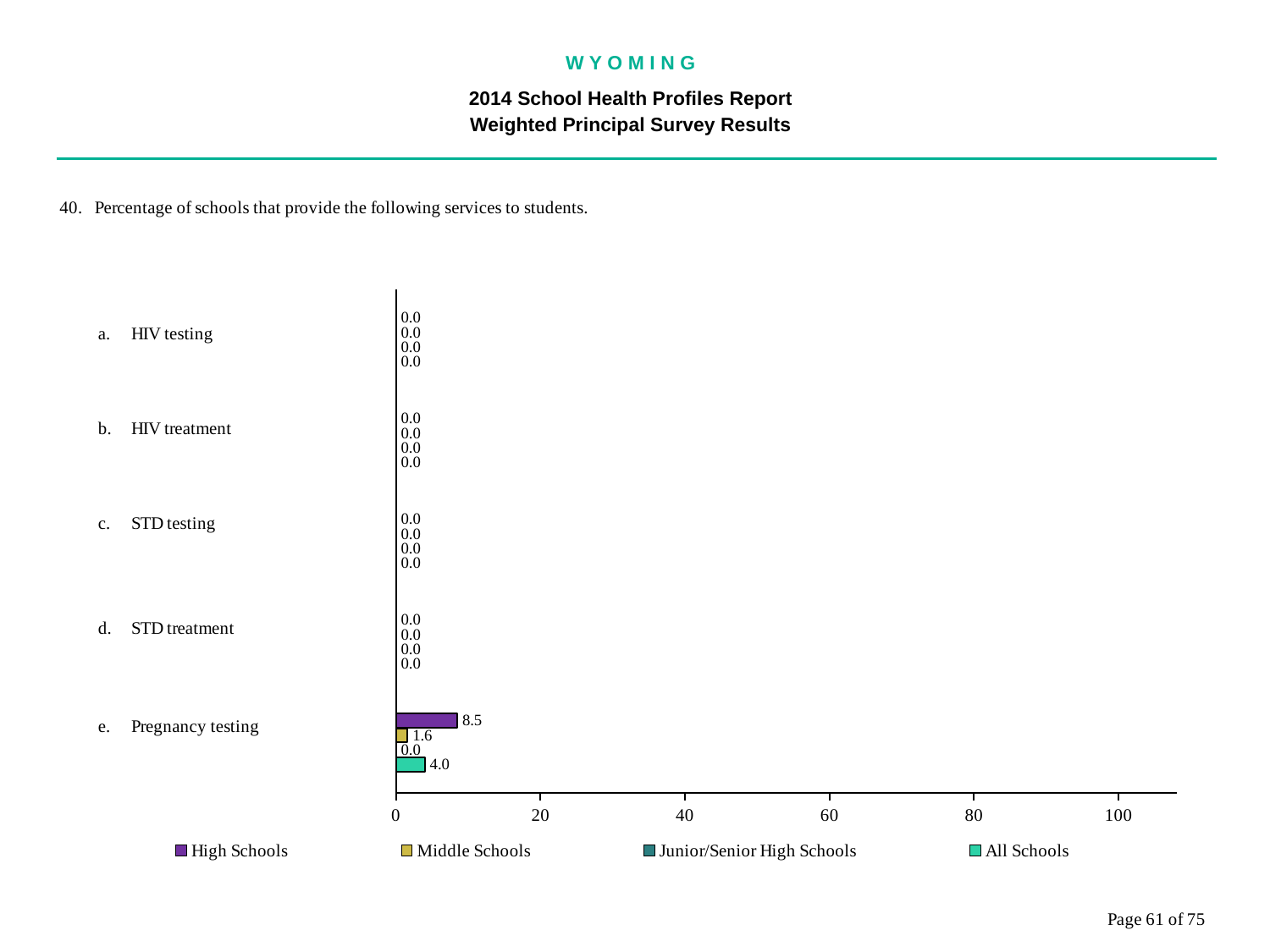
How many service categories are shown in the chart? 5 What is the value for All Schools for Pregnancy testing? 4.0 What is the difference between the High Schools and All Schools values for Pregnancy testing? 4.5 Which is larger for Pregnancy testing: the Middle Schools value or the All Schools value? All Schools What is the value for Junior/Senior High Schools for Pregnancy testing? 0.0 What kind of chart is shown on the slide? bar chart What is the value for High Schools for HIV testing? 0.0 Is the High Schools value for Pregnancy testing greater or less than 20? less What is the value for Middle Schools for Pregnancy testing? 1.6 What is the value for High Schools for Pregnancy testing? 8.5 How many series does the legend list? 4 Which school type has the highest value for Pregnancy testing? High Schools